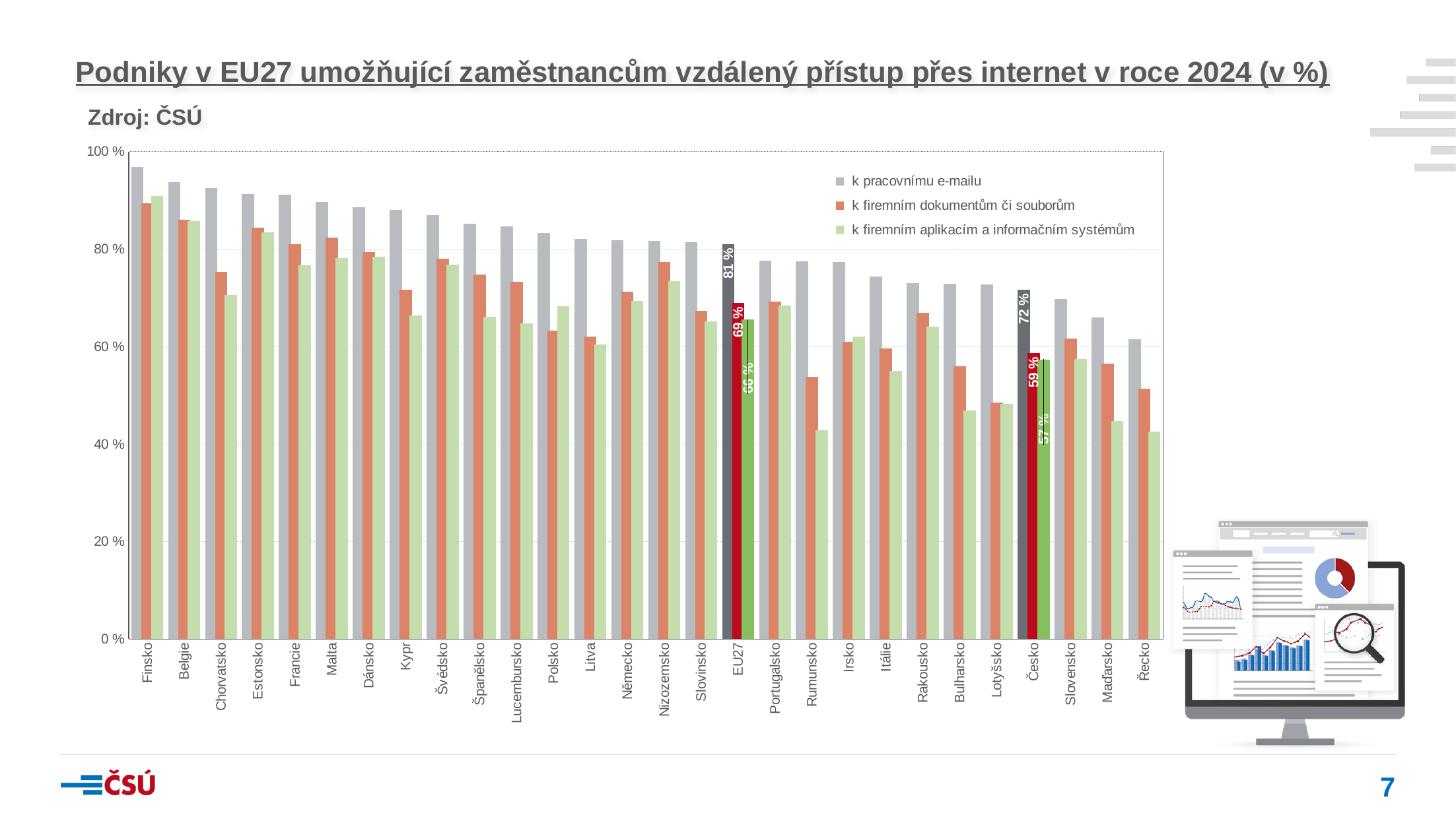
Is the value for Rumunsko in the series 'k firemním aplikacím a informačním systémům' greater or less than 60 %? less Which category has the highest value in the series 'k pracovnímu e-mailu'? Finsko How many categories (countries plus EU27) are shown on the x axis? 28 What is the value for EU27 in the series 'k firemním dokumentům či souborům'? 69 % How many series does the legend list? 3 What is the value for Česko in the series 'k firemním dokumentům či souborům'? 59 % Which has the larger 'k pracovnímu e-mailu' value, EU27 or Česko? EU27 What is the value for EU27 in the series 'k pracovnímu e-mailu'? 81 % What kind of chart is shown on the slide? bar chart What is the value for Česko in the series 'k pracovnímu e-mailu'? 72 % Which category has the lowest value in the series 'k pracovnímu e-mailu'? Řecko What is the difference between the 'k pracovnímu e-mailu' and 'k firemním dokumentům či souborům' values for Česko? 13 percentage points